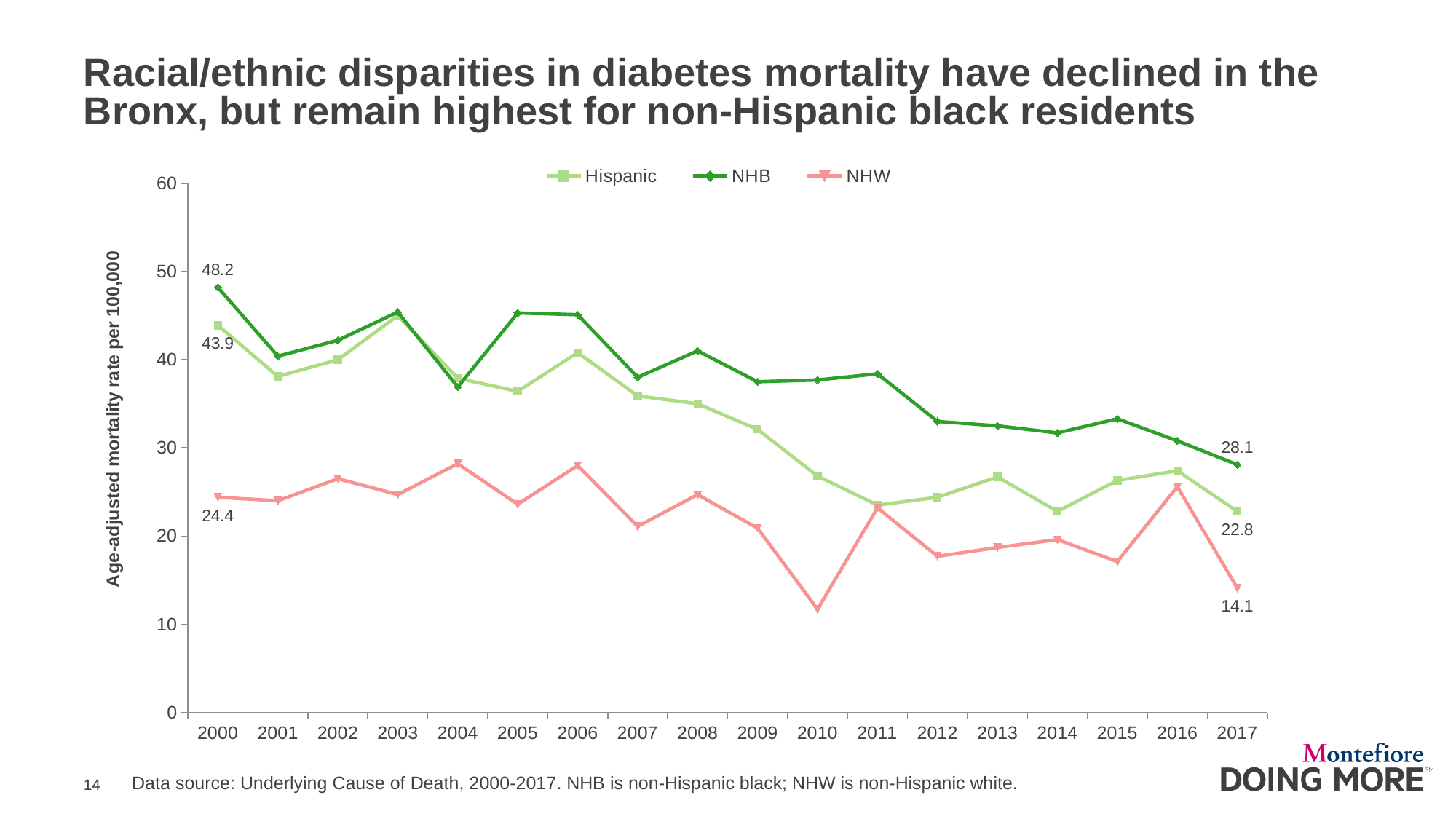
What is the age-adjusted mortality rate for NHW in 2000? 24.4 What is the age-adjusted mortality rate for NHB in 2000? 48.2 How many series does the legend list? 3 Does the NHB mortality rate generally rise or fall from 2000 to 2017? fall Is the value for NHW in 2010 greater or less than 20? less What is the age-adjusted mortality rate for Hispanic residents in 2017? 22.8 What is the age-adjusted mortality rate for NHW in 2017? 14.1 By how much did the NHB mortality rate decline from 2000 to 2017? 20.1 How many years are shown on the x axis? 18 In 2017, which series has the higher mortality rate, NHB or Hispanic? NHB What kind of chart is shown on the slide? line chart What is the difference between the Hispanic mortality rate in 2000 and in 2017? 21.1